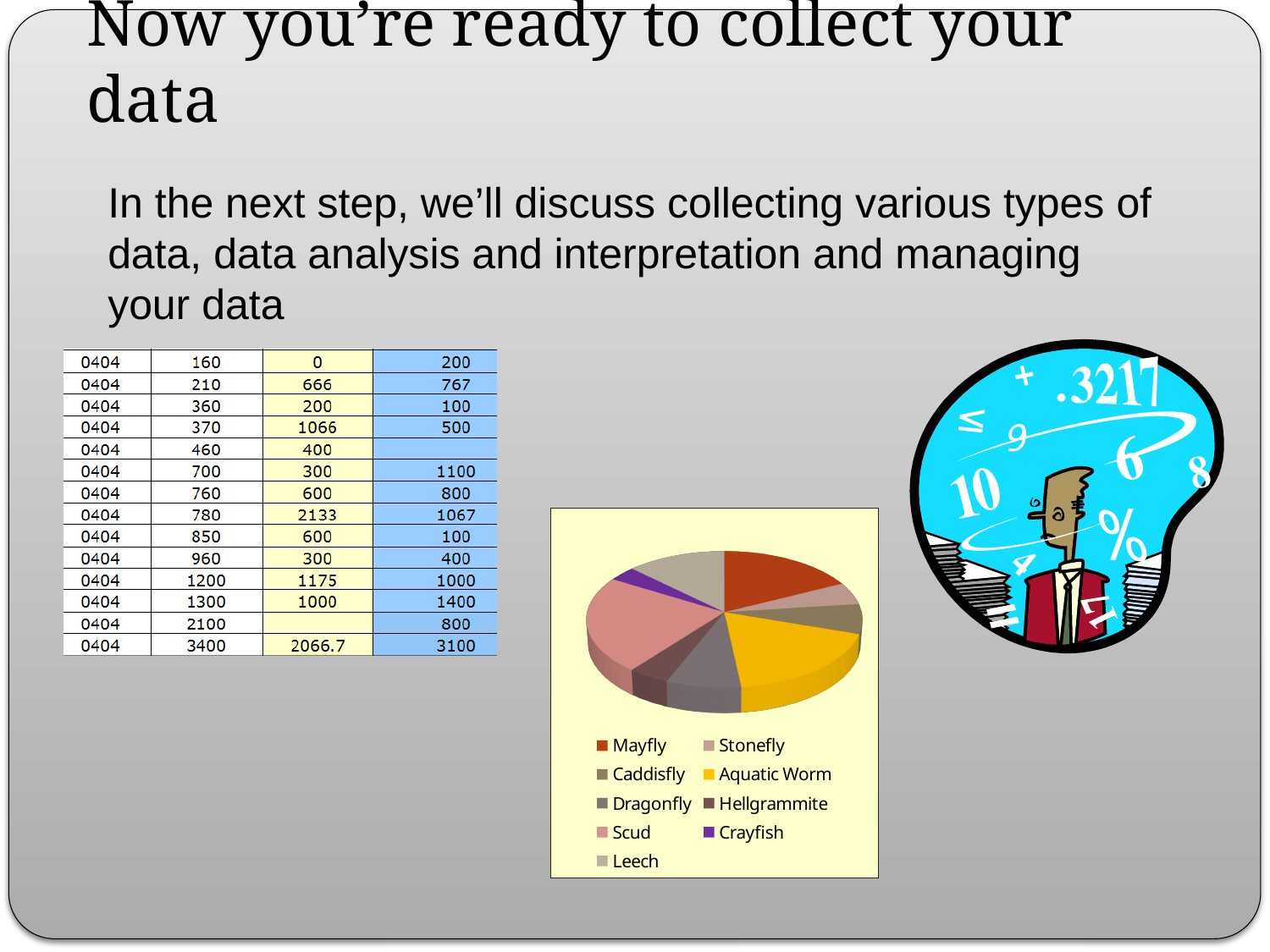
What colour is the Crayfish slice in the pie chart? purple How many categories does the pie chart's legend list? 9 Which slice is larger in the pie chart, Scud or Hellgrammite? Scud Which slice is larger in the pie chart, Aquatic Worm or Stonefly? Aquatic Worm Which legend entry in the pie chart is shown in yellow? Aquatic Worm Which slice is larger in the pie chart, Aquatic Worm or Crayfish? Aquatic Worm What kind of chart is shown on the slide? pie chart Which category has the smallest slice in the pie chart? Crayfish